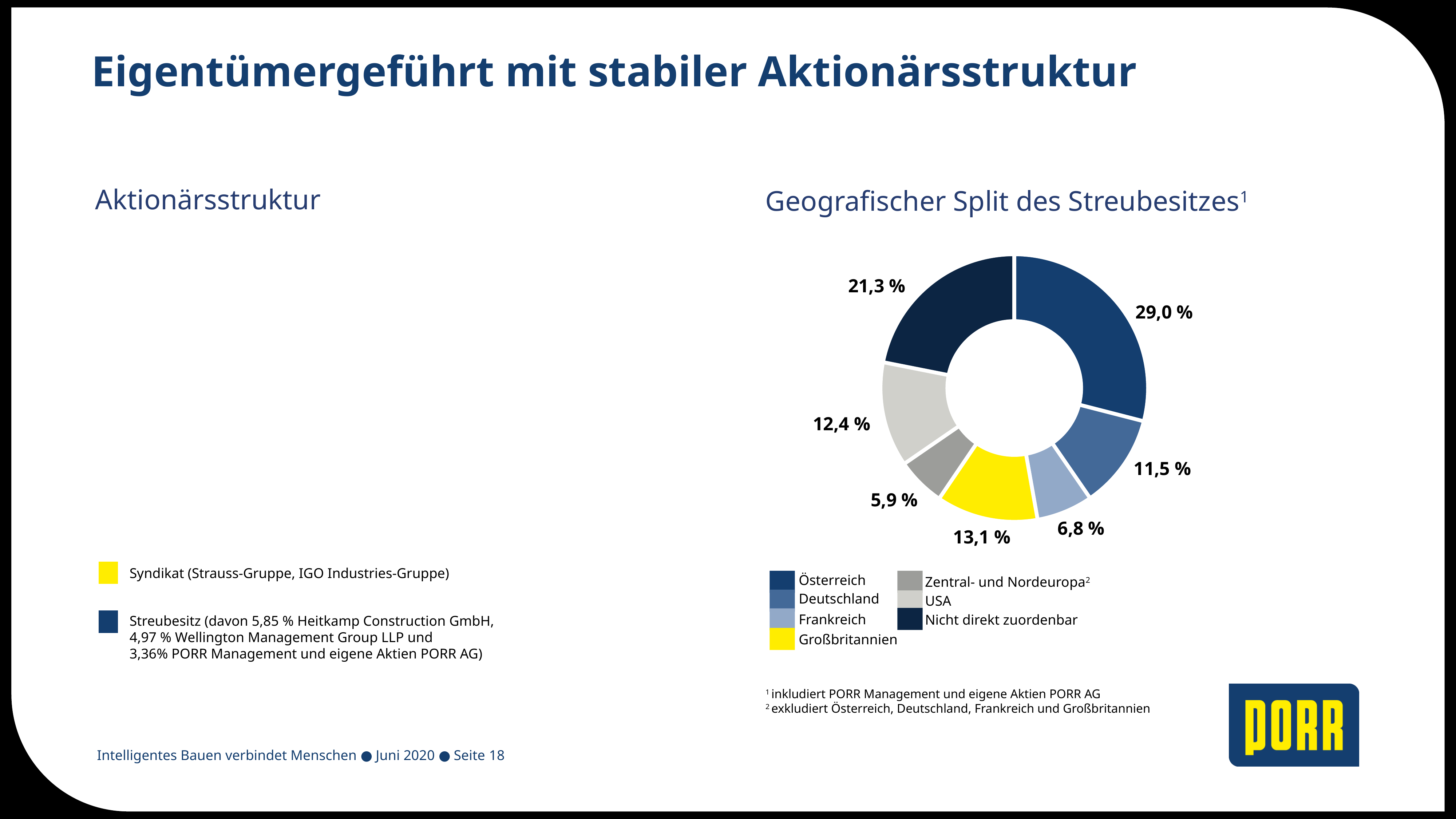
In the chart 'Geografischer Split des Streubesitzes', which category has the smallest share? Zentral- und Nordeuropa In the chart 'Geografischer Split des Streubesitzes', what share is shown for Nicht direkt zuordenbar? 21,3 % In the chart 'Geografischer Split des Streubesitzes', what share is shown for Großbritannien? 13,1 % In the chart 'Geografischer Split des Streubesitzes', what is the difference between the shares of Österreich and Nicht direkt zuordenbar? 7,7 % In the chart 'Geografischer Split des Streubesitzes', what share is shown for Deutschland? 11,5 % How many categories does the chart 'Geografischer Split des Streubesitzes' show? 7 In the chart 'Geografischer Split des Streubesitzes', what share is shown for Österreich? 29,0 % In the chart 'Geografischer Split des Streubesitzes', which has the larger share, Großbritannien or USA? Großbritannien In the chart 'Geografischer Split des Streubesitzes', which category has the largest share? Österreich In the chart 'Geografischer Split des Streubesitzes', what share is shown for USA? 12,4 % In the chart 'Geografischer Split des Streubesitzes', which category is shown in yellow? Großbritannien What kind of chart is 'Geografischer Split des Streubesitzes'? Pie chart (donut)